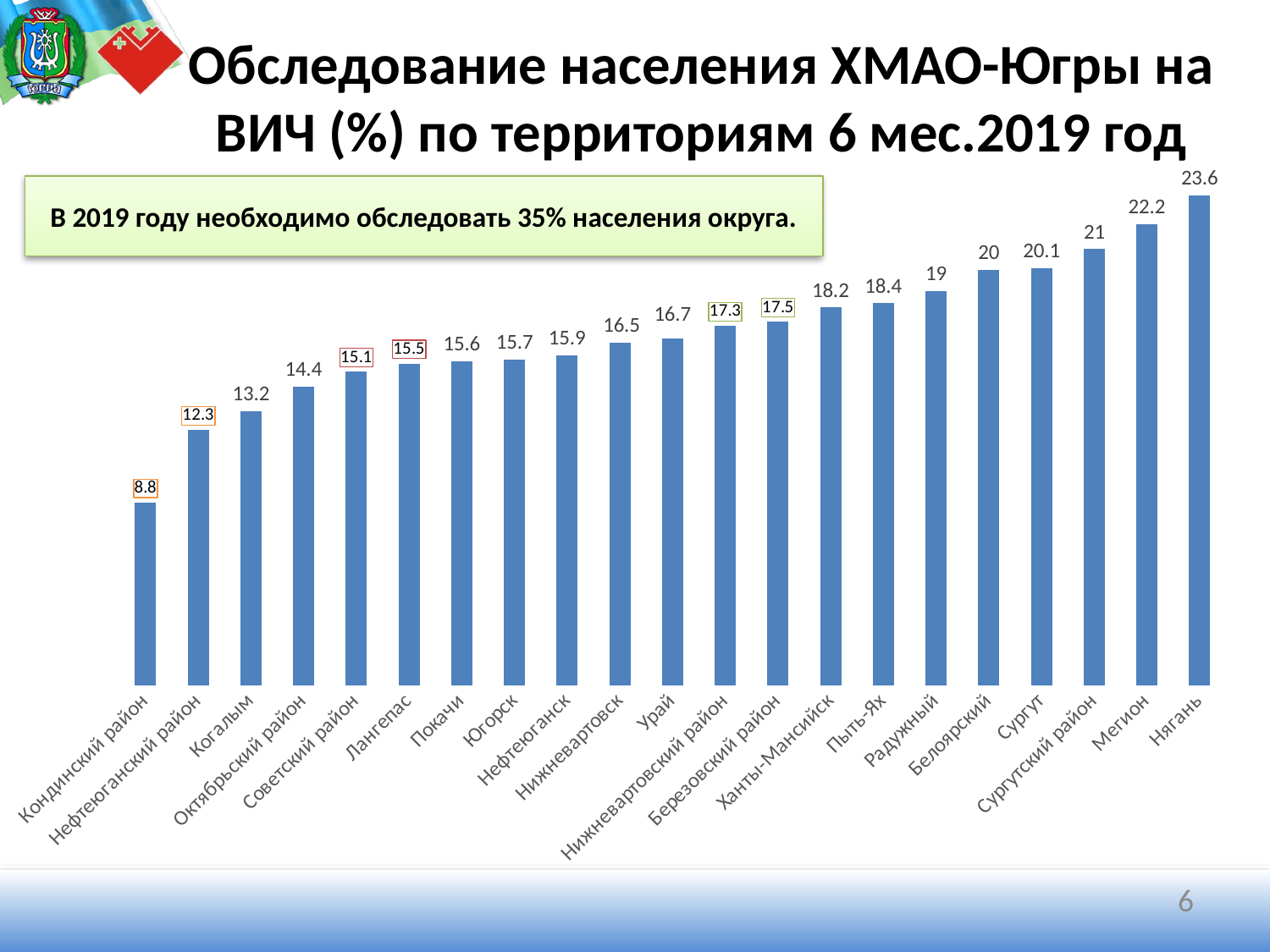
What is the value for Сургут? 20.1 What type of chart is shown on the slide? Bar chart What is the value for Кондинский район? 8.8 What is the difference between the values for Нягань and Кондинский район? 14.8 How many territories are shown in the chart? 21 What is the value for Нижневартовский район? 17.3 What is the value for Ханты-Мансийск? 18.2 Do the values rise or fall from left to right along the x axis? Rise Which has a larger value, Когалым or Радужный? Радужный What is the difference between the values for Мегион and Сургутский район? 1.2 Which territory has the lowest value? Кондинский район Which territory has the highest value? Нягань